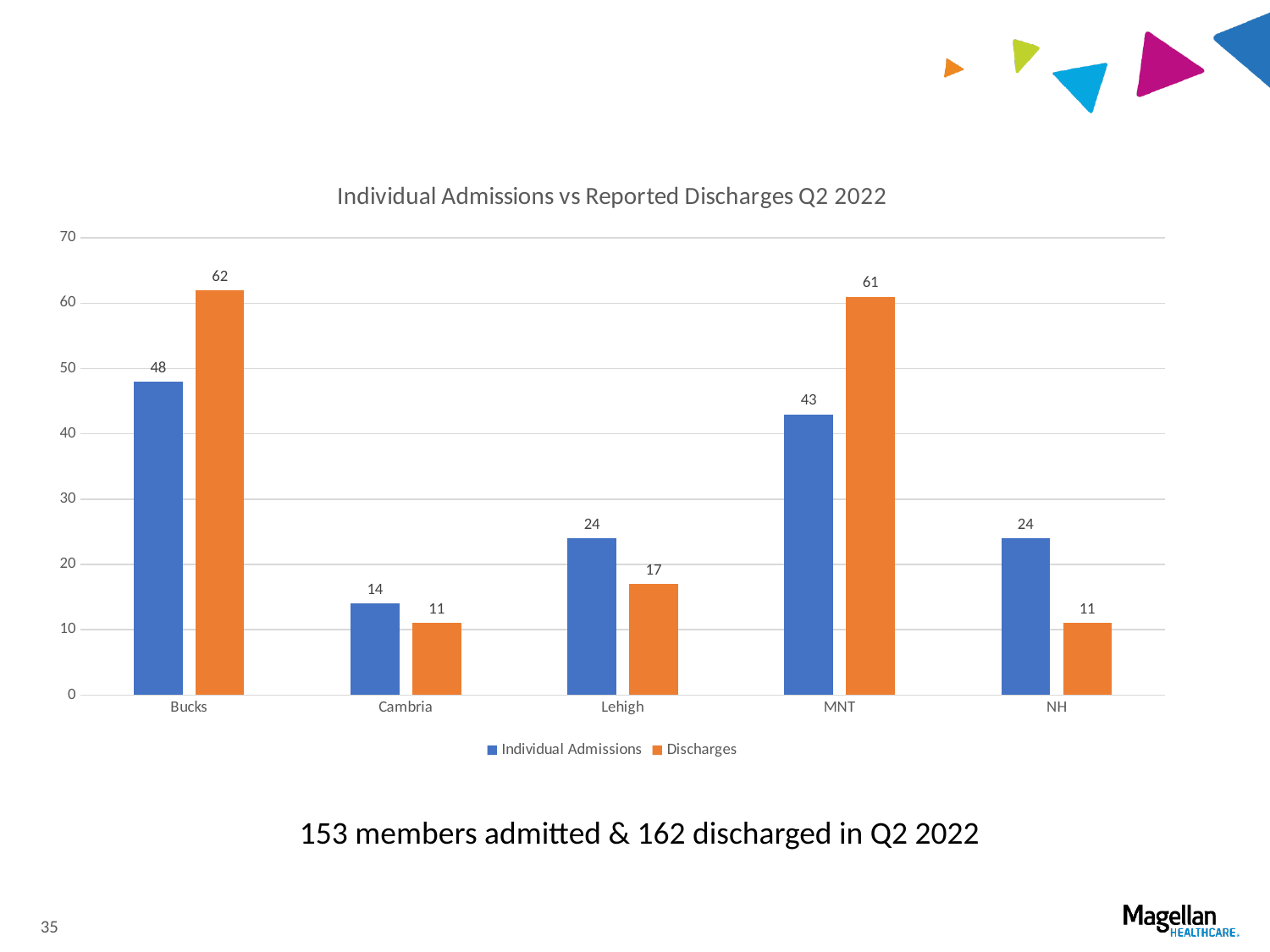
What is the title of the chart? Individual Admissions vs Reported Discharges Q2 2022 What is the difference between Individual Admissions and Discharges in NH? 13 What kind of chart is shown on the slide? Bar chart Which is larger in Lehigh, Individual Admissions or Discharges? Individual Admissions Which category has the highest value for Discharges? Bucks What is the difference between Discharges and Individual Admissions in Bucks? 14 Which category has the lowest value for Individual Admissions? Cambria What is the value for Discharges in MNT? 61 How many categories are shown on the x axis? 5 What is the value for Discharges in Lehigh? 17 How many series does the legend list? 2 What is the value for Individual Admissions in Bucks? 48